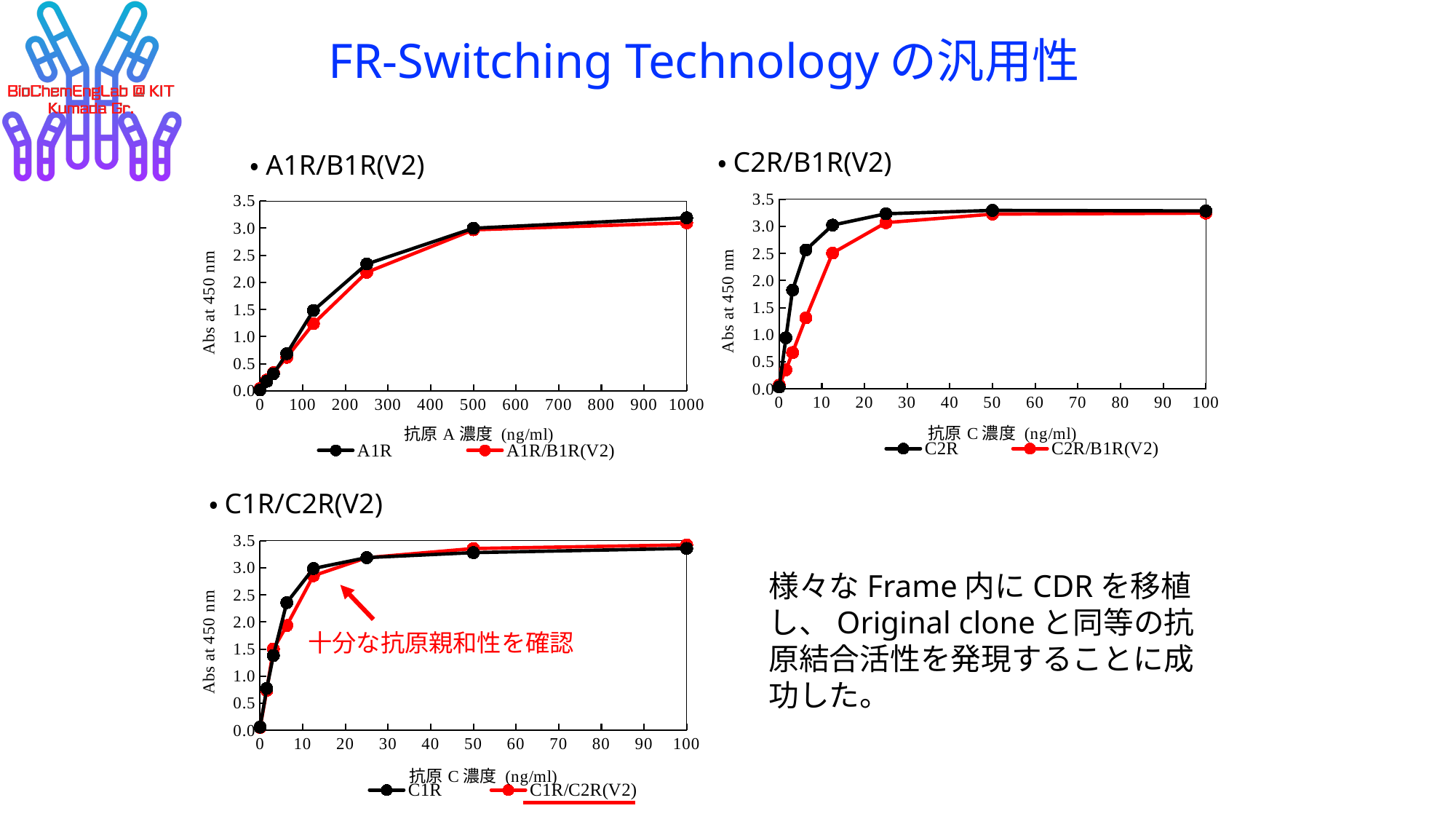
In the C2R/B1R(V2) chart, is the C2R/B1R(V2) value at about 12.5 ng/ml greater or less than 3.0? less In the C1R/C2R(V2) chart, is the C1R value at 25 ng/ml greater or less than 3.0? greater How many series does the legend of the C2R/B1R(V2) chart list? 2 What kind of chart is the A1R/B1R(V2) chart? line chart In the C1R/C2R(V2) chart, what are the two series named in the legend? C1R and C1R/C2R(V2) In the A1R/B1R(V2) chart, do the values rise or fall as the antigen A concentration increases? rise In the C1R/C2R(V2) chart, which series has the higher value at about 6 ng/ml, C1R or C1R/C2R(V2)? C1R In the A1R/B1R(V2) chart, is the A1R value at 500 ng/ml greater or less than 2.5? greater In the A1R/B1R(V2) chart, what is the y-axis label? Abs at 450 nm In the A1R/B1R(V2) chart, which series has the higher value at about 125 ng/ml, A1R or A1R/B1R(V2)? A1R In the C2R/B1R(V2) chart, do the values rise or fall as the antigen C concentration increases? rise In the C2R/B1R(V2) chart, which series has the higher value at about 6 ng/ml, C2R or C2R/B1R(V2)? C2R